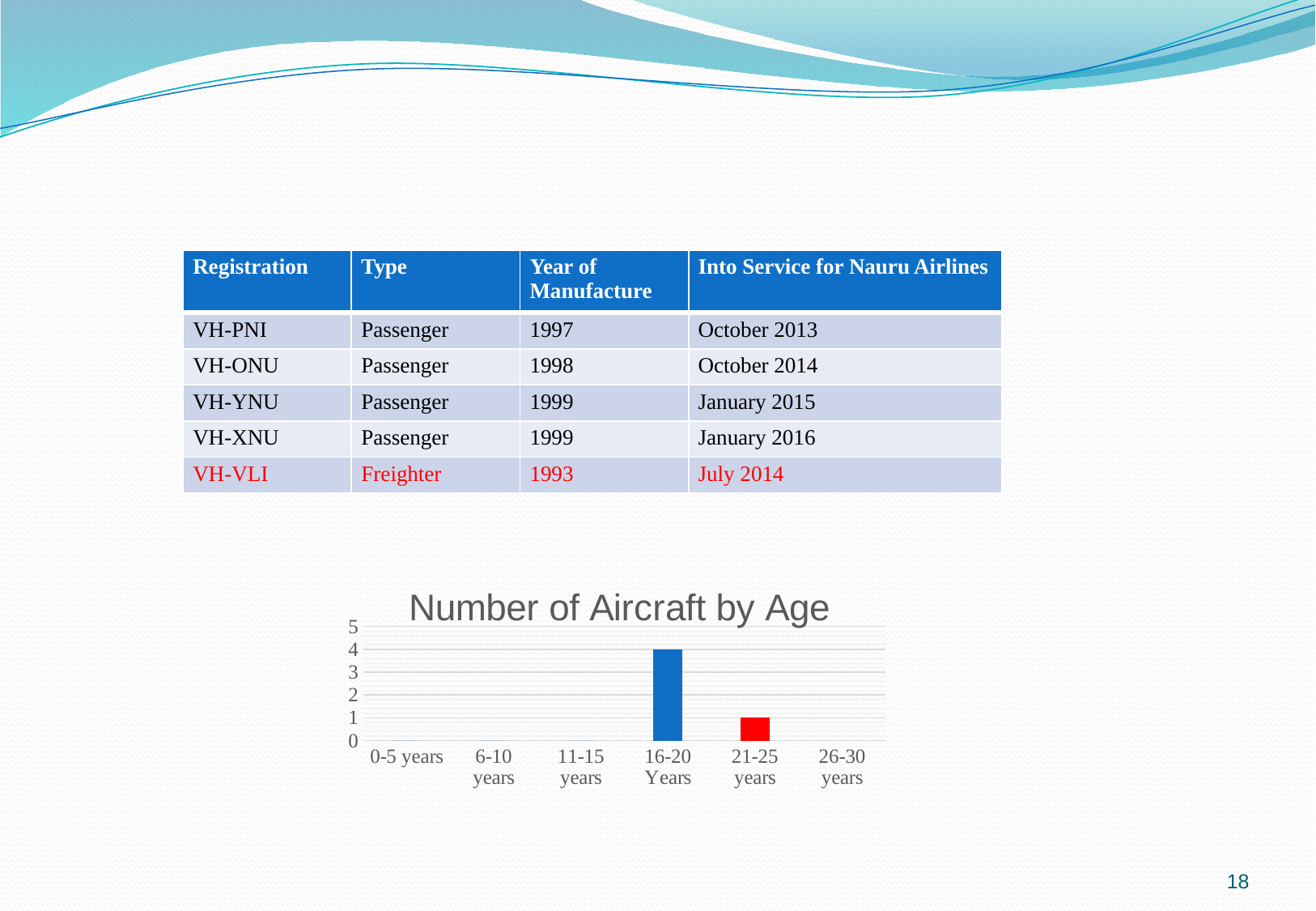
In the "Number of Aircraft by Age" chart, what is the value for 16-20 Years? 4 What is the highest value shown on the y axis of the "Number of Aircraft by Age" chart? 5 In the "Number of Aircraft by Age" chart, is the value for 16-20 Years greater or less than 3? greater In the "Number of Aircraft by Age" chart, is the value for 21-25 years greater or less than 2? less What is the title of the chart on the slide? Number of Aircraft by Age Which age category has the highest value in the "Number of Aircraft by Age" chart? 16-20 Years In the "Number of Aircraft by Age" chart, what is the value for 21-25 years? 1 How many age categories are shown on the x axis of the "Number of Aircraft by Age" chart? 6 What kind of chart is "Number of Aircraft by Age"? bar chart In the "Number of Aircraft by Age" chart, what is the value for 0-5 years? 0 In the "Number of Aircraft by Age" chart, which is larger: the value for 16-20 Years or the value for 21-25 years? 16-20 Years In the "Number of Aircraft by Age" chart, what is the difference between the values for 16-20 Years and 21-25 years? 3